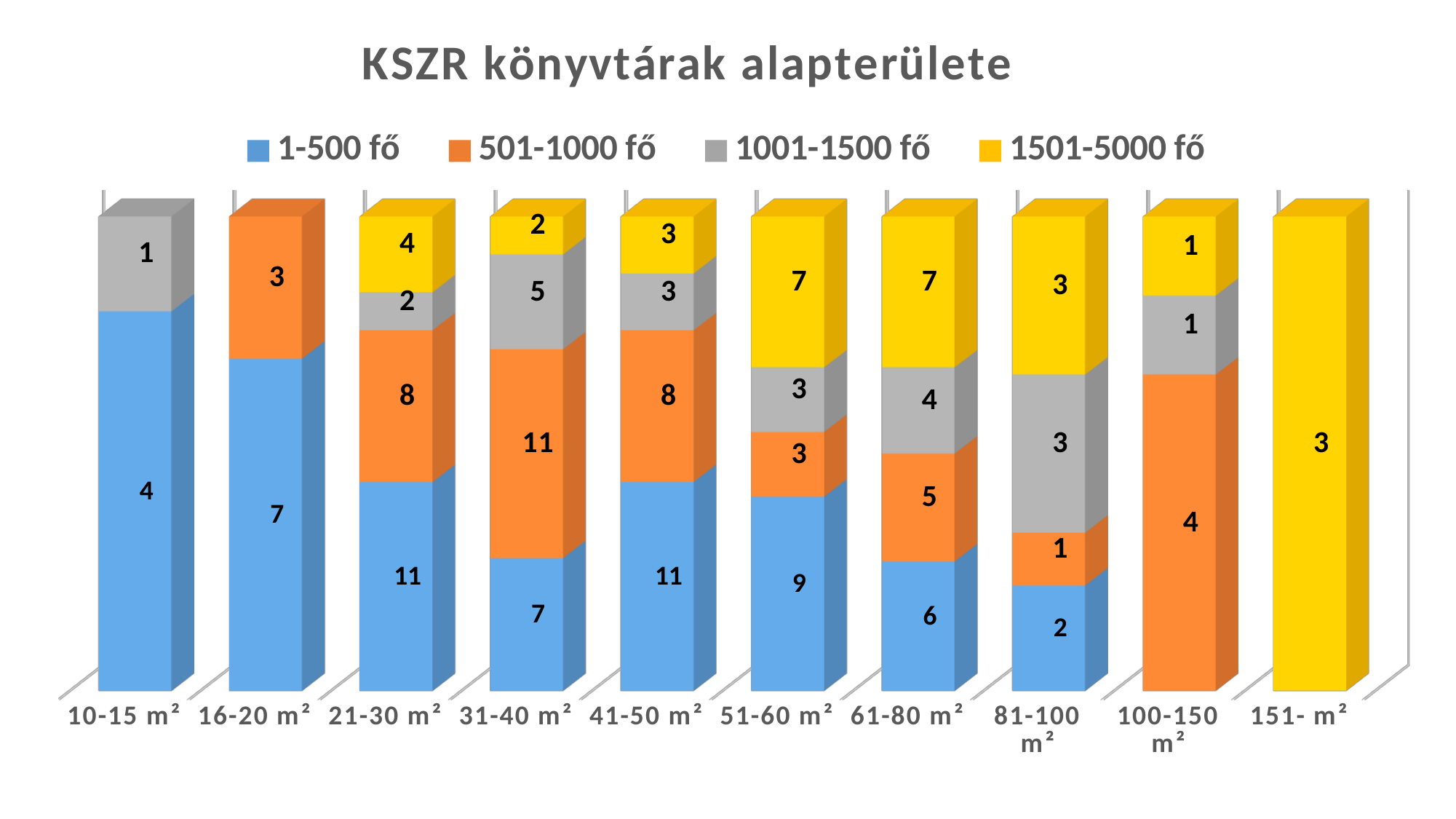
What kind of chart is shown on the slide? Stacked bar chart What is the value for 1001-1500 fő in the 81-100 m² category? 3 Which category has the highest value for the 1001-1500 fő series? 31-40 m² Which category has the highest value for the 501-1000 fő series? 31-40 m² How many series does the legend list? 4 What is the value for 1-500 fő in the 31-40 m² category? 7 How many categories are shown on the x axis? 10 What is the value for 501-1000 fő in the 100-150 m² category? 4 What is the difference between the 501-1000 fő values for 31-40 m² and 21-30 m²? 3 What is the total of all series for the 21-30 m² bar? 25 Which is larger: the 1-500 fő value for 51-60 m² or for 61-80 m²? 51-60 m² What is the value for 1501-5000 fő in the 51-60 m² category? 7